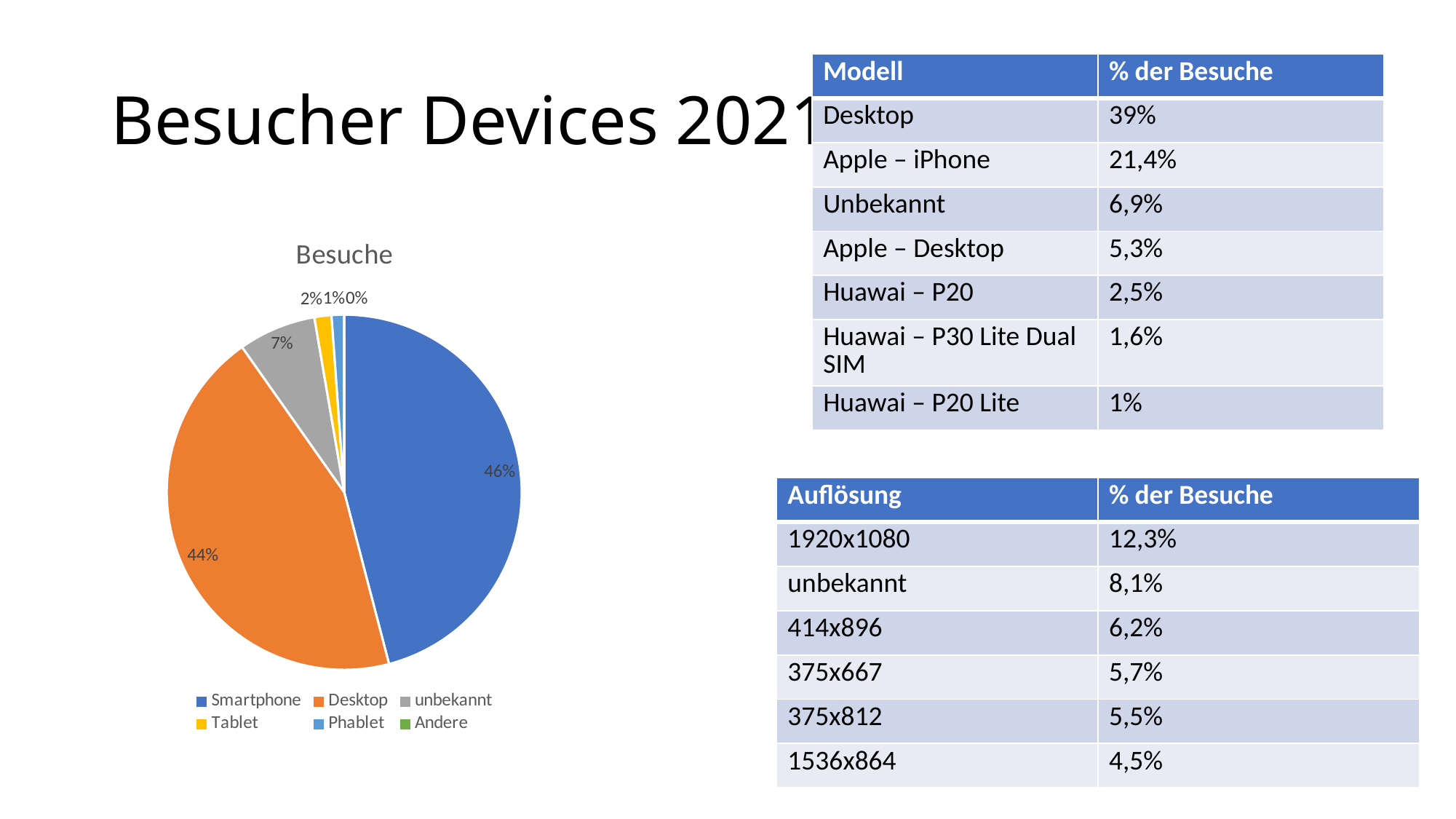
What is the title of the pie chart? Besuche What share of the pie chart does Desktop have? 44% What share of the pie chart does Phablet have? 1% Which category has the smallest slice in the pie chart? Andere What kind of chart is shown on the slide? pie chart Which category has the largest slice in the pie chart? Smartphone What share of the pie chart does Smartphone have? 46% How many categories does the legend of the pie chart list? 6 Which colour represents Desktop in the pie chart? orange What is the difference in percentage points between the Smartphone and Desktop slices? 2%